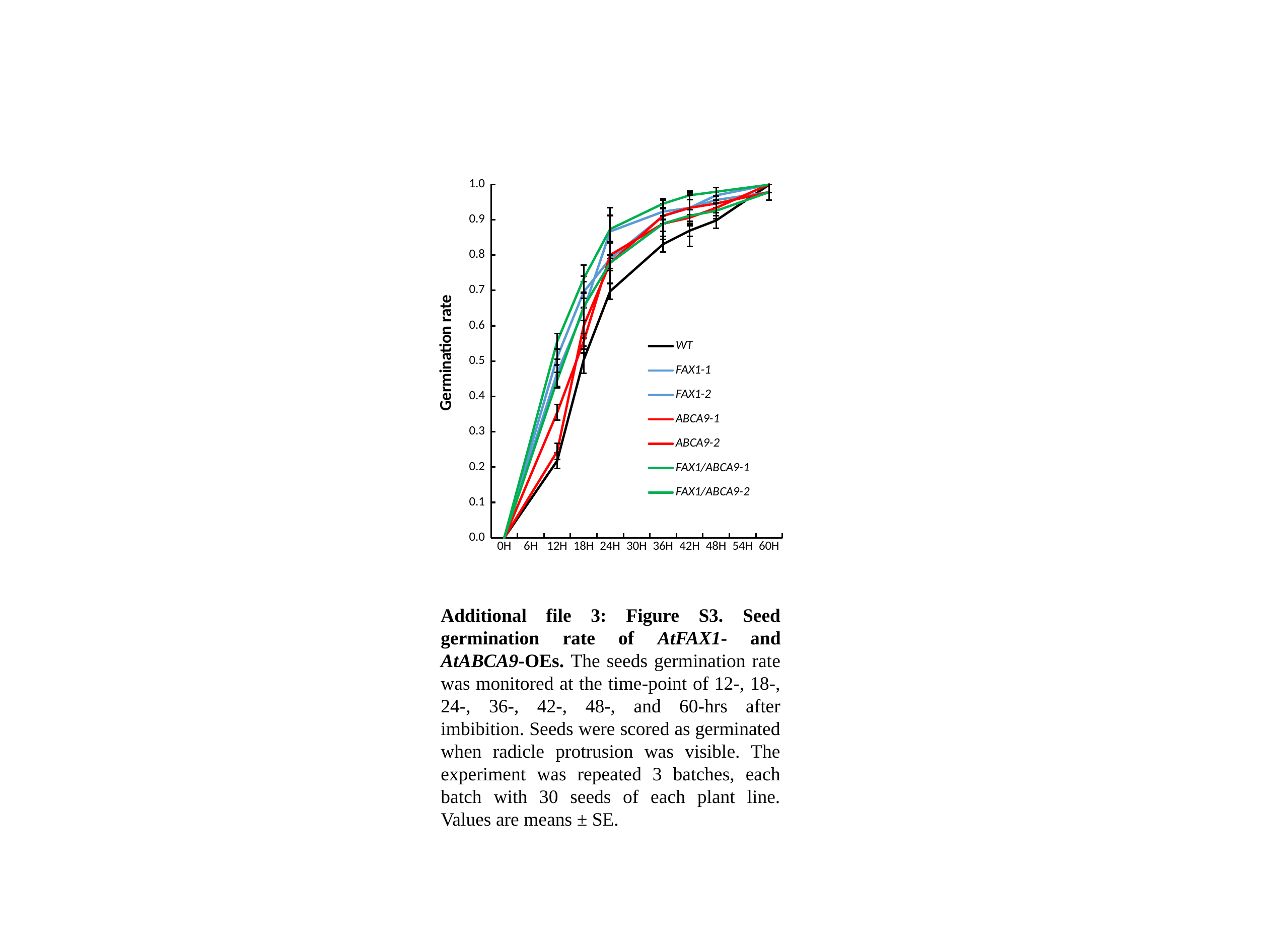
Is the germination rate for WT at 12H greater or less than 0.3? less What kind of chart is shown on the slide? line chart How many series does the legend list? 7 What is the label of the y axis? Germination rate Do the germination rate values rise or fall along the x axis from 0H to 60H? rise How many time-point ticks are labelled on the x axis? 11 At 12H, which has the higher germination rate, WT or FAX1-1? FAX1-1 Which series has the lowest germination rate at 36H? WT Is the germination rate for WT at 36H greater or less than 0.8? greater What is the germination rate for WT at 0H? 0.0 Is the germination rate for FAX1/ABCA9-1 at 24H greater or less than 0.8? greater What colour is the WT line in the legend? black